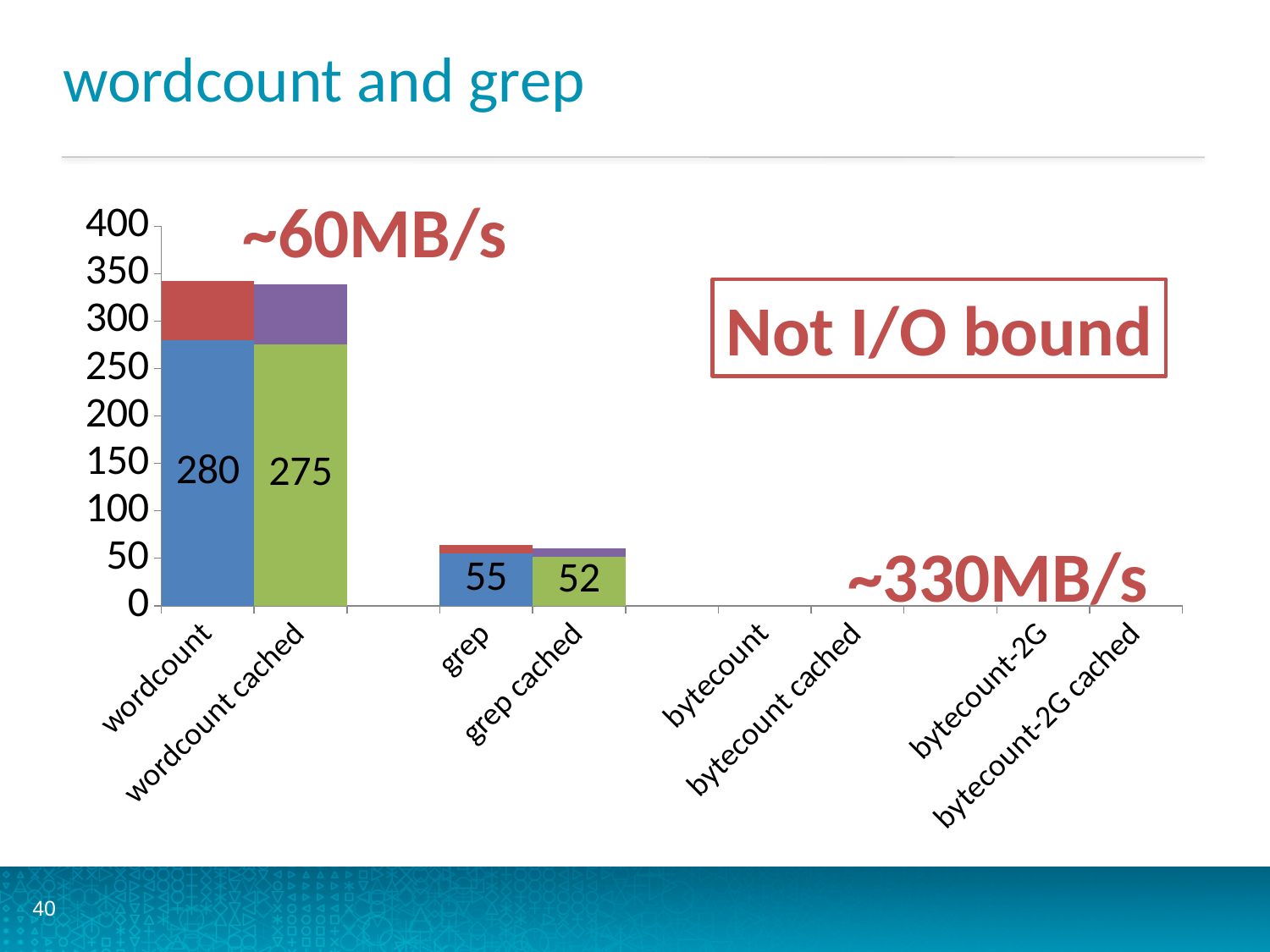
How many categories are listed on the x axis? 8 What is the difference between the labelled values for grep and grep cached? 3 What kind of chart is shown on the slide? bar chart Which category has the lowest labelled value? grep cached Is the total height of the wordcount bar greater or less than 300? greater Which has a larger labelled value, grep or grep cached? grep Which category has the highest labelled value? wordcount What is the labelled value for grep? 55 What is the difference between the labelled values for wordcount and wordcount cached? 5 What is the labelled value for wordcount cached? 275 What is the labelled value for wordcount? 280 What is the labelled value for grep cached? 52